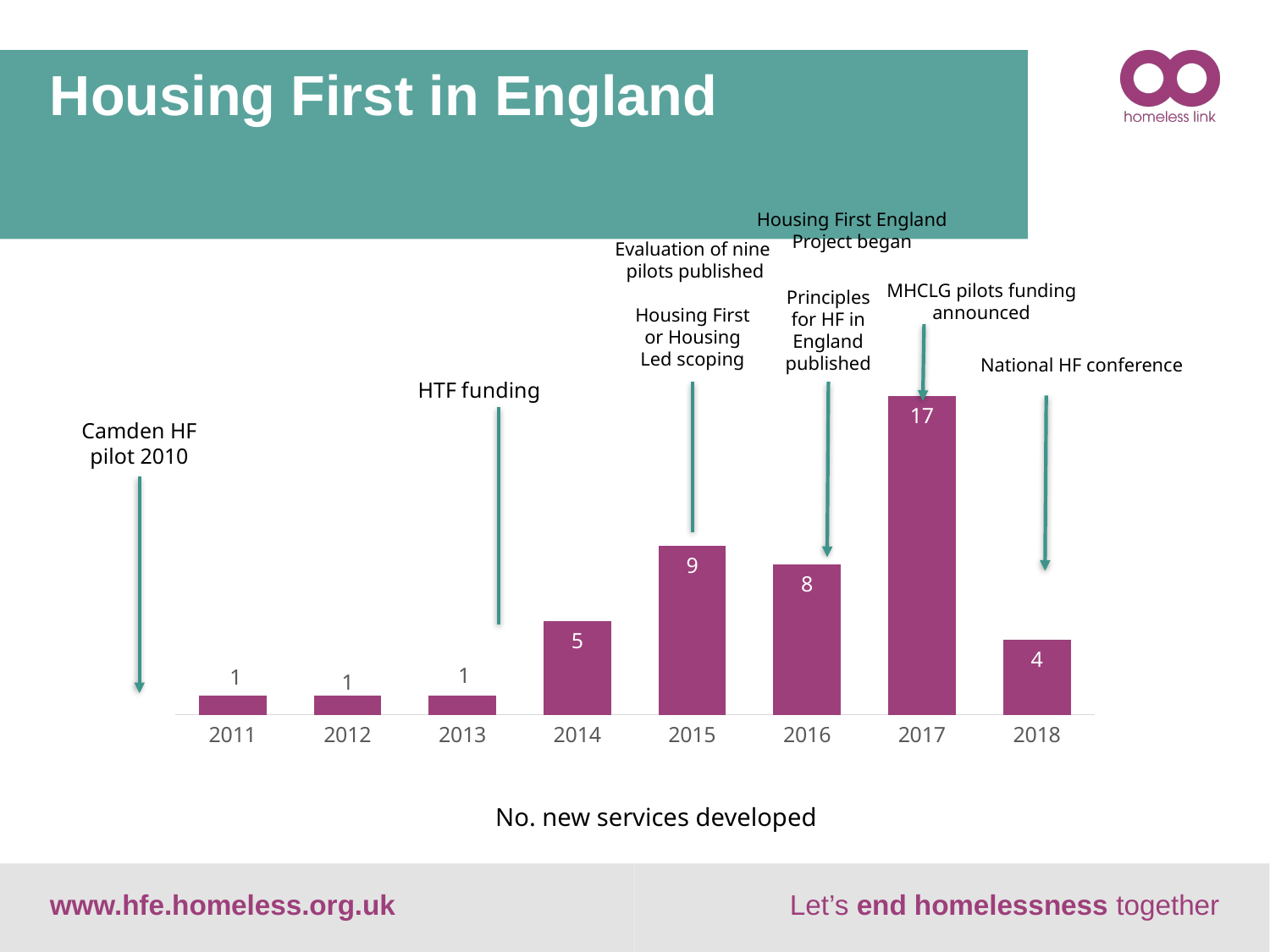
How many years are shown on the x axis of the chart? 8 Which year had more new services developed, 2015 or 2016? 2015 How many new services were developed in 2018? 4 Do the values rise or fall from 2017 to 2018? Fall How many new services were developed in 2017? 17 What is the difference between the number of new services developed in 2017 and in 2016? 9 Which year has the highest number of new services developed? 2017 Which year had more new services developed, 2014 or 2018? 2014 What is the difference between the number of new services developed in 2015 and in 2014? 4 How many new services were developed in 2015? 9 What kind of chart is shown on the slide? Bar chart What is the caption below the chart describing what the bars measure? No. new services developed